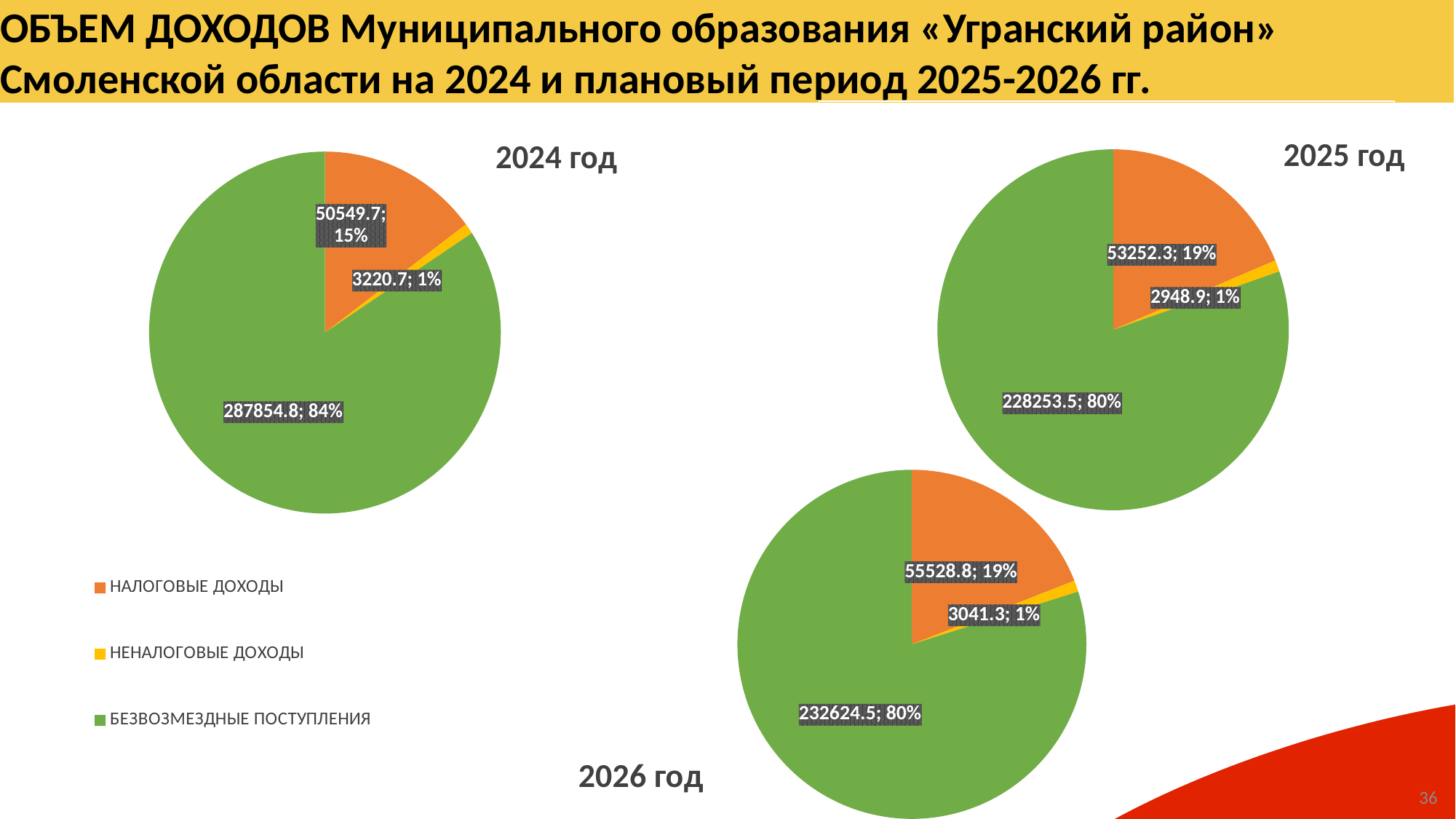
On the 2026 год pie chart, which category has the smallest slice? НЕНАЛОГОВЫЕ ДОХОДЫ On the 2024 год pie chart, what is the value for НАЛОГОВЫЕ ДОХОДЫ? 50549.7 What type of chart is used for the 2024 год data? Pie chart On the 2024 год pie chart, which category has the largest slice? БЕЗВОЗМЕЗДНЫЕ ПОСТУПЛЕНИЯ Which is larger: НАЛОГОВЫЕ ДОХОДЫ on the 2025 год chart or НАЛОГОВЫЕ ДОХОДЫ on the 2026 год chart? 2026 год On the 2025 год pie chart, what is the difference between БЕЗВОЗМЕЗДНЫЕ ПОСТУПЛЕНИЯ and НАЛОГОВЫЕ ДОХОДЫ? 175001.2 Which colour represents НЕНАЛОГОВЫЕ ДОХОДЫ in the legend? Yellow On the 2026 год pie chart, what is the value for БЕЗВОЗМЕЗДНЫЕ ПОСТУПЛЕНИЯ? 232624.5 On the 2024 год pie chart, what share does БЕЗВОЗМЕЗДНЫЕ ПОСТУПЛЕНИЯ have? 84% On the 2025 год pie chart, what share does НАЛОГОВЫЕ ДОХОДЫ have? 19% On the 2025 год pie chart, what is the value for НЕНАЛОГОВЫЕ ДОХОДЫ? 2948.9 How many categories does each pie chart show? 3